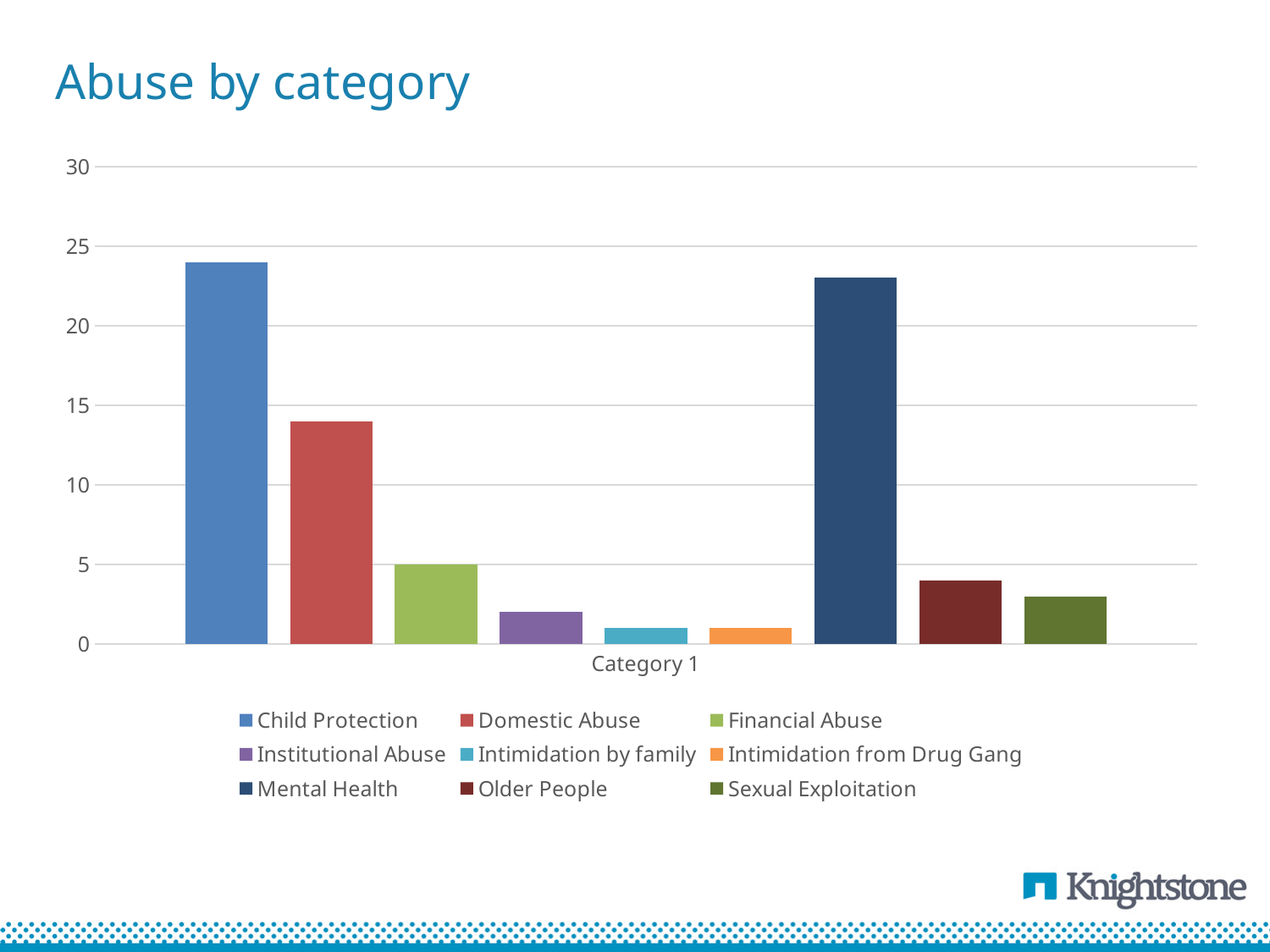
Is the value for Older People greater or less than 5? less What kind of chart is shown on the slide? bar chart What is the title of the chart? Abuse by category Is the value for Domestic Abuse greater or less than 15? less Is the value for Child Protection greater or less than 20? greater Which is larger, the value for Mental Health or the value for Older People? Mental Health Which is larger, the value for Domestic Abuse or the value for Sexual Exploitation? Domestic Abuse Which series has the highest value? Child Protection How many series does the legend list? 9 What label is shown on the horizontal axis beneath the bars? Category 1